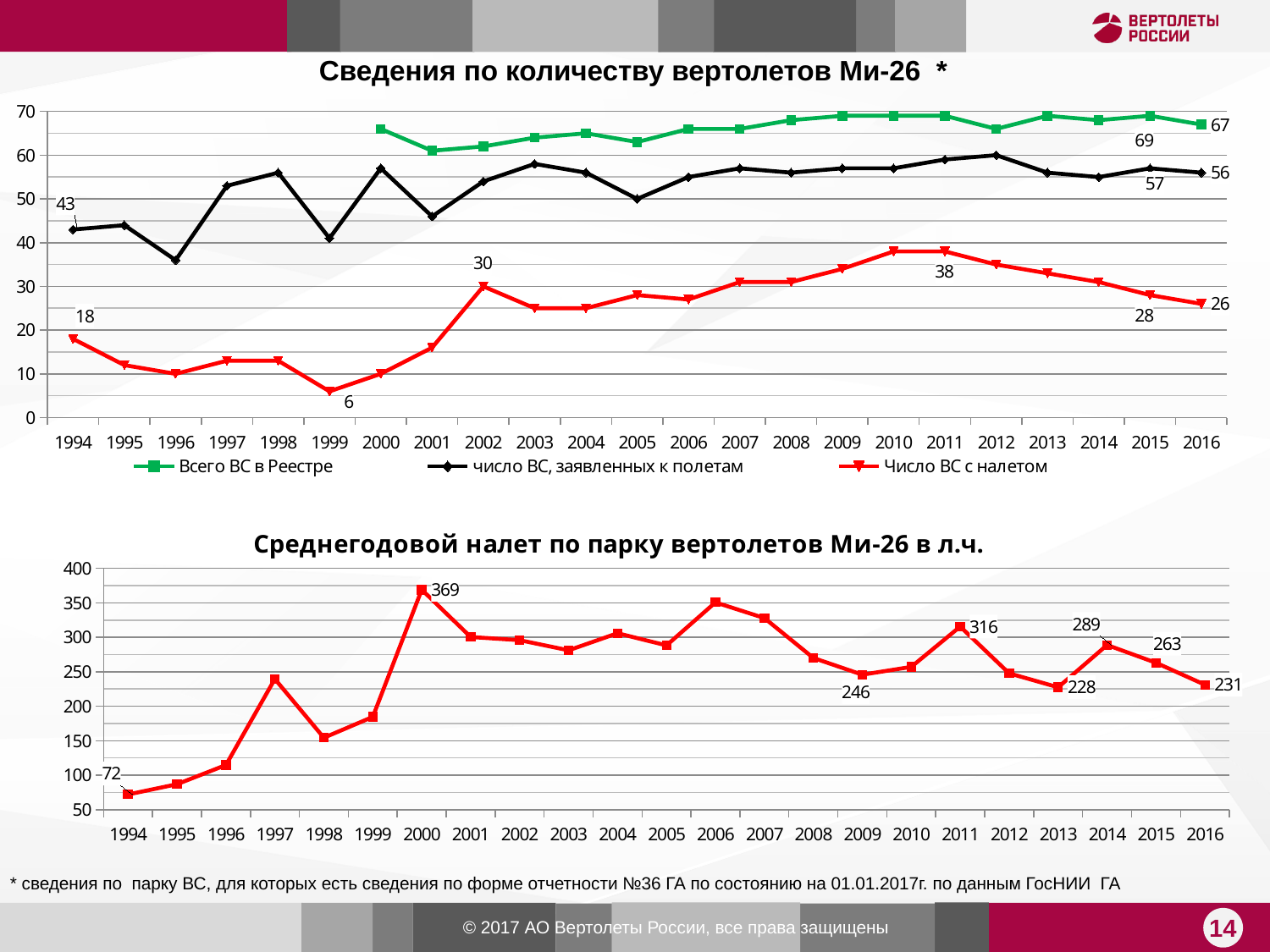
In the top chart 'Сведения по количеству вертолетов Ми-26', in which year is 'Число ВС с налетом' lowest? 1999 In the top chart 'Сведения по количеству вертолетов Ми-26', what is the value of 'Число ВС с налетом' in 1994? 18 In the bottom chart 'Среднегодовой налет по парку вертолетов Ми-26 в л.ч.', what is the value for 2009? 246 In the top chart 'Сведения по количеству вертолетов Ми-26', what is the difference between 'Всего ВС в Реестре' and 'число ВС, заявленных к полетам' in 2016? 11 In the bottom chart 'Среднегодовой налет по парку вертолетов Ми-26 в л.ч.', which year has the larger value, 2011 or 2014? 2011 In the top chart 'Сведения по количеству вертолетов Ми-26', is the value of 'число ВС, заявленных к полетам' in 1996 greater or less than 40? less In the top chart 'Сведения по количеству вертолетов Ми-26', what is the value of 'Всего ВС в Реестре' in 2016? 67 In the bottom chart 'Среднегодовой налет по парку вертолетов Ми-26 в л.ч.', which year has the highest value? 2000 In the top chart 'Сведения по количеству вертолетов Ми-26', what is the value of 'число ВС, заявленных к полетам' in 2016? 56 What kind of chart is the bottom chart 'Среднегодовой налет по парку вертолетов Ми-26 в л.ч.'? line chart In the bottom chart 'Среднегодовой налет по парку вертолетов Ми-26 в л.ч.', what is the difference between the values for 2015 and 2016? 32 How many series does the legend of the top chart 'Сведения по количеству вертолетов Ми-26' list? 3